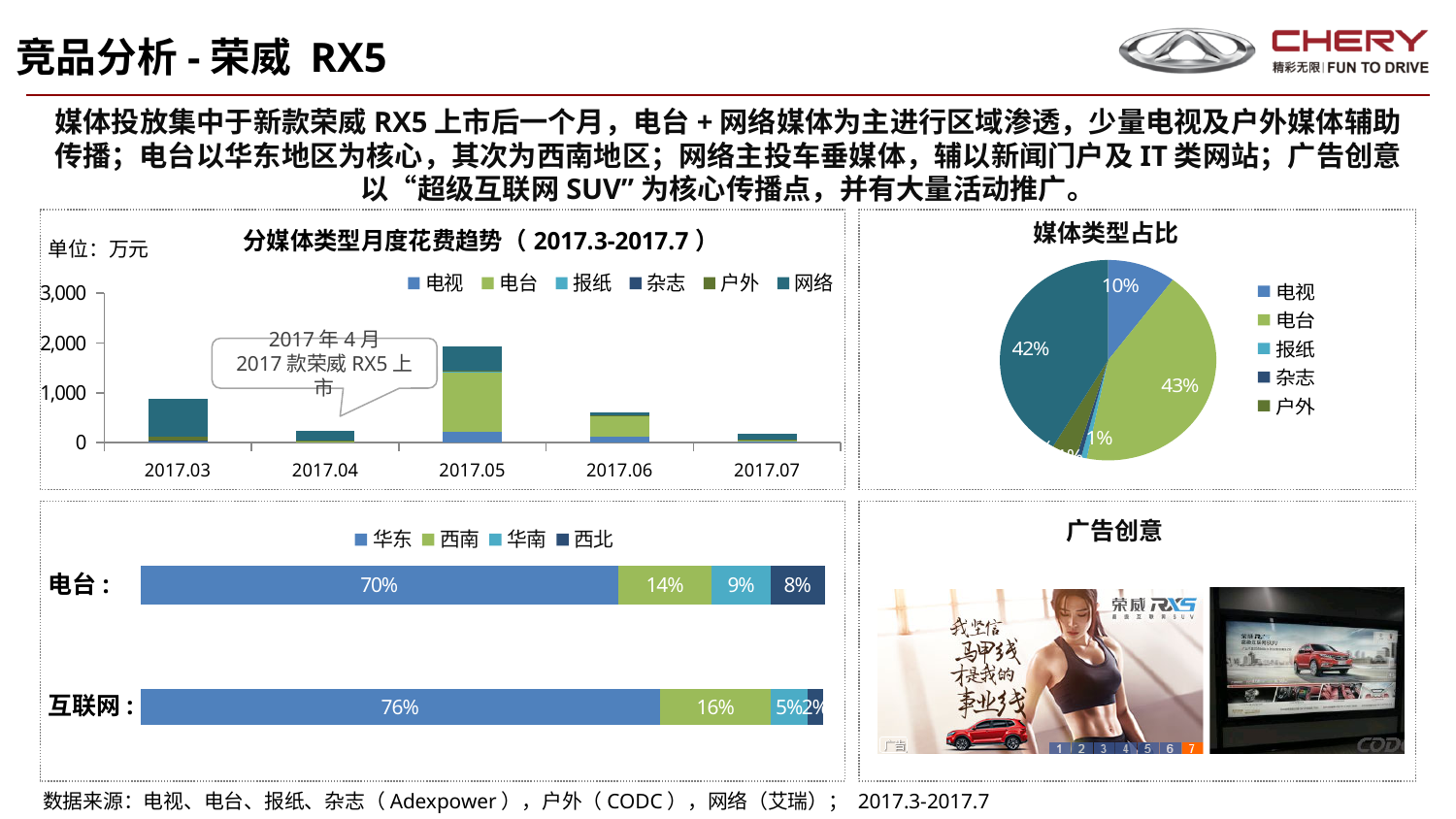
In the chart titled 分媒体类型月度花费趋势, which month has the highest total spend? 2017.05 In the chart titled 分媒体类型月度花费趋势, is the total value for 2017.05 greater or less than 1,000? greater In the bottom-left horizontal bar chart, which is larger: the 西南 share for 电台 or the 西南 share for 互联网? 互联网 In the chart titled 分媒体类型月度花费趋势, is the total value for 2017.06 greater or less than 1,000? less In the 媒体类型占比 pie chart, what is the difference between the 43% slice and the 42% slice? 1 percentage point In the bottom-left horizontal bar chart, what is the 华东 share for 电台? 70% In the 媒体类型占比 pie chart, what share is labelled for 电台? 43% In the 媒体类型占比 pie chart, what share is labelled for 电视? 10% In the chart titled 分媒体类型月度花费趋势, how many series does the legend list? 6 In the bottom-left horizontal bar chart, what is the difference between the 华东 share for 互联网 and the 华东 share for 电台? 6 percentage points What kind of chart is the 媒体类型占比 chart? pie chart In the chart titled 分媒体类型月度花费趋势, how many months are shown on the x axis? 5